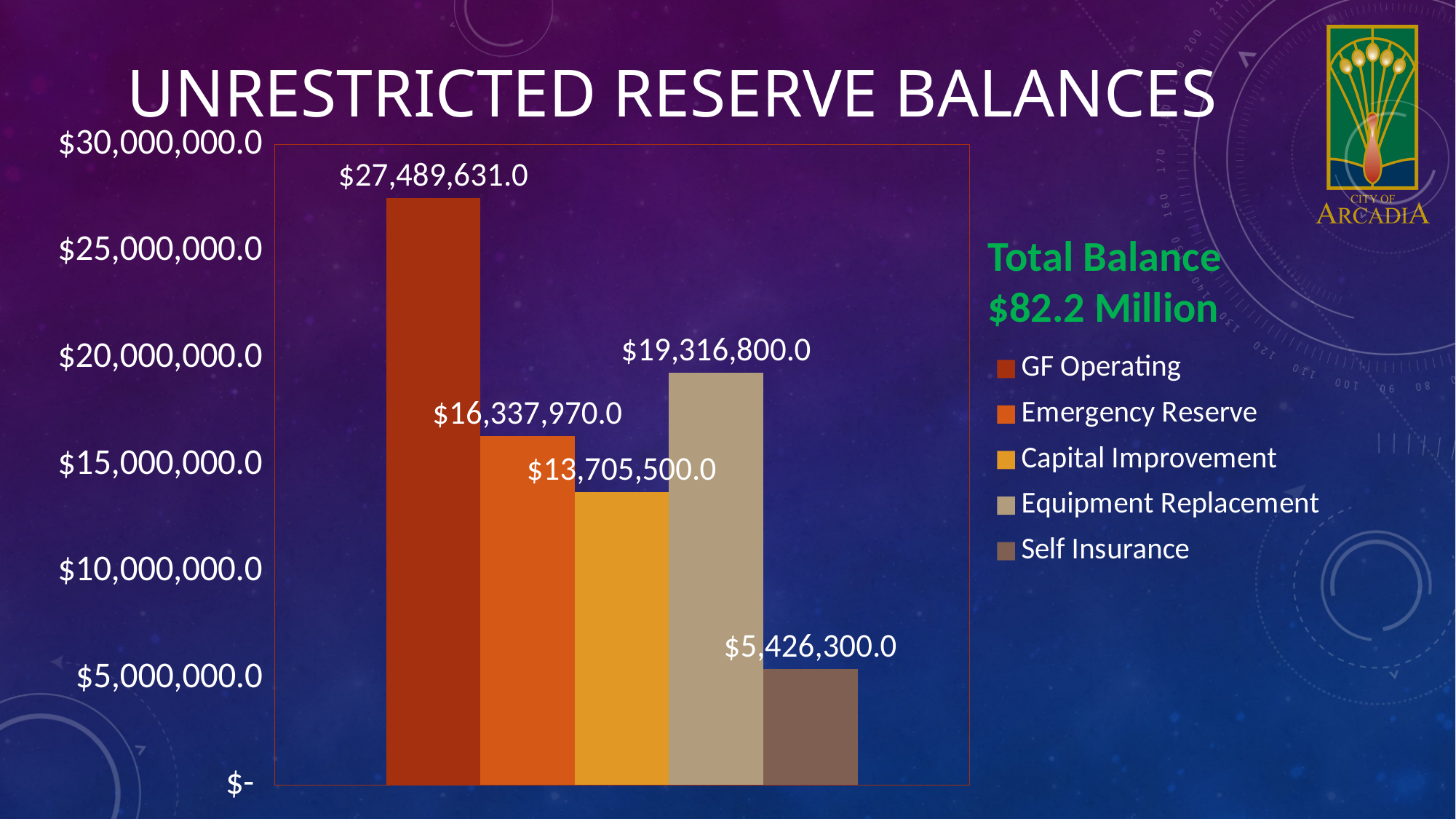
Which reserve has the highest balance? GF Operating What kind of chart is shown on the slide? Bar chart What is the value for Equipment Replacement? $19,316,800.0 What is the value for GF Operating? $27,489,631.0 Which reserve has the lowest balance? Self Insurance What is the difference between the Emergency Reserve and Capital Improvement balances? $2,632,470.0 Which is larger, Emergency Reserve or Equipment Replacement? Equipment Replacement What is the value for Capital Improvement? $13,705,500.0 What is the difference between the GF Operating and Equipment Replacement balances? $8,172,831.0 How many bars are plotted in the chart? 5 How many entries does the legend list? 5 What is the value for Self Insurance? $5,426,300.0